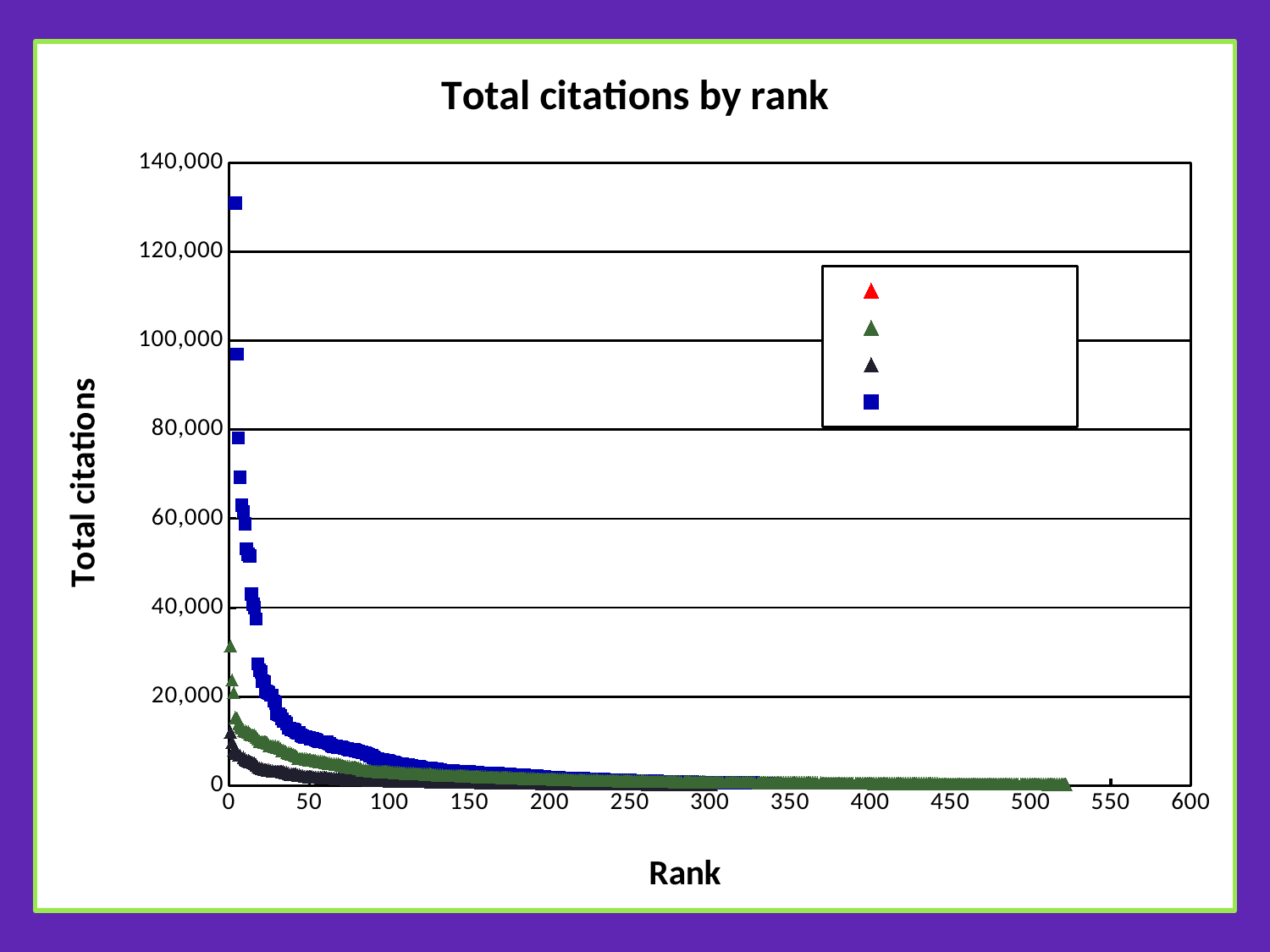
What is the label on the vertical axis of the chart? Total citations What kind of chart is shown on the slide? scatter chart Is the highest value of the black triangle series greater or less than 20,000? less Is the second-highest value of the blue square series greater or less than 80,000? greater What is the title of the chart? Total citations by rank Do the total citations rise or fall as rank increases along the x axis? fall Is the highest value of the blue square series greater or less than 120,000? greater Which series reaches the highest total citations: the blue square series or the green triangle series? blue square series How many series does the chart's legend list? 4